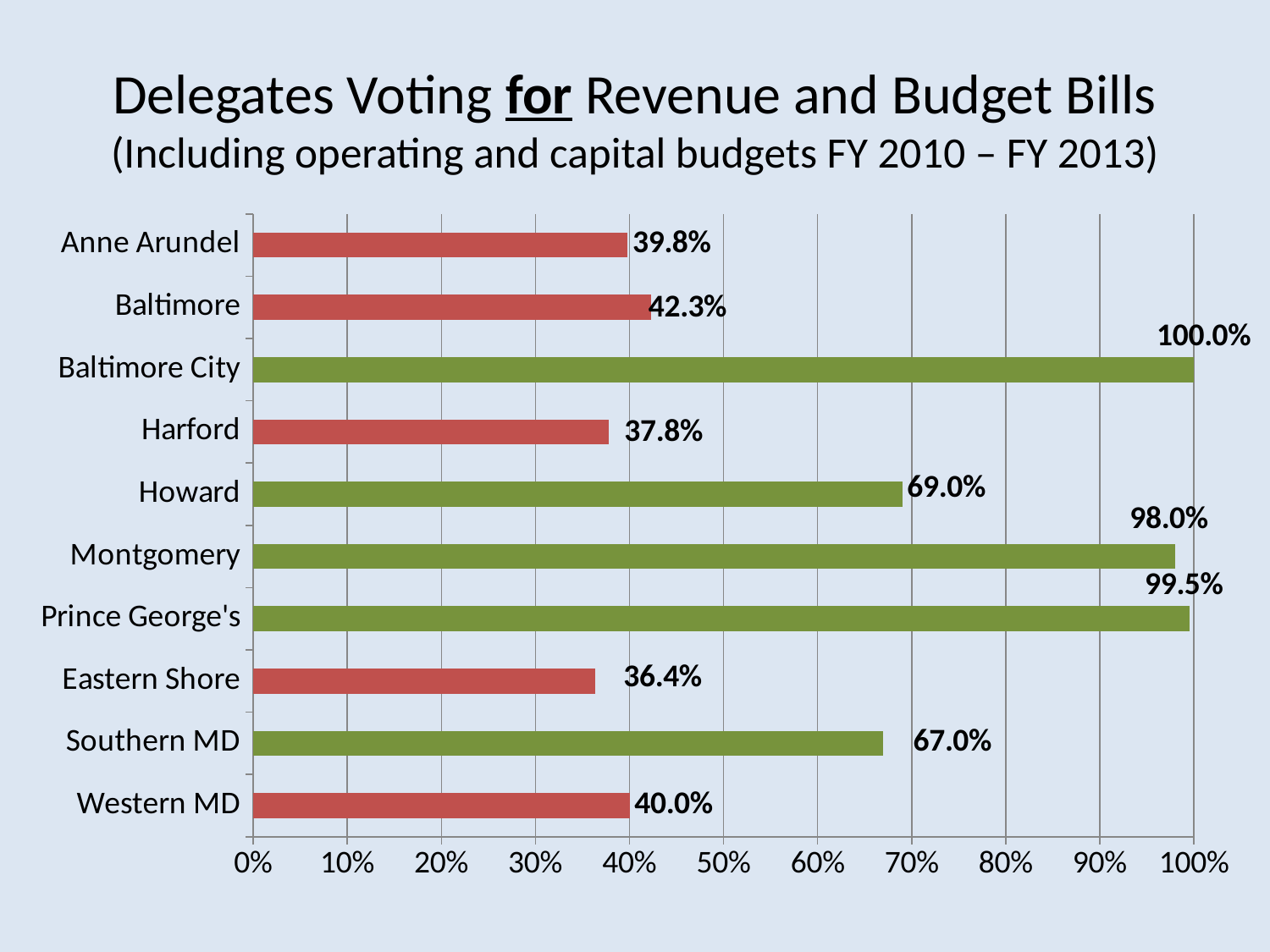
What colour are the bars for categories with values below 50%? Red Which category has the lowest value? Eastern Shore Which category has the highest value? Baltimore City Which is larger, the value for Baltimore or the value for Western MD? Baltimore How many categories are shown on the chart? 10 What is the difference between the values for Prince George's and Montgomery? 1.5 percentage points What is the value shown for Eastern Shore? 36.4% What kind of chart is shown on the slide? Bar chart Is the value for Southern MD greater or less than 60%? greater What is the value shown for Howard? 69.0% What percentage of delegates from Baltimore City voted for revenue and budget bills? 100.0% What is the difference between the values for Montgomery and Harford? 60.2 percentage points